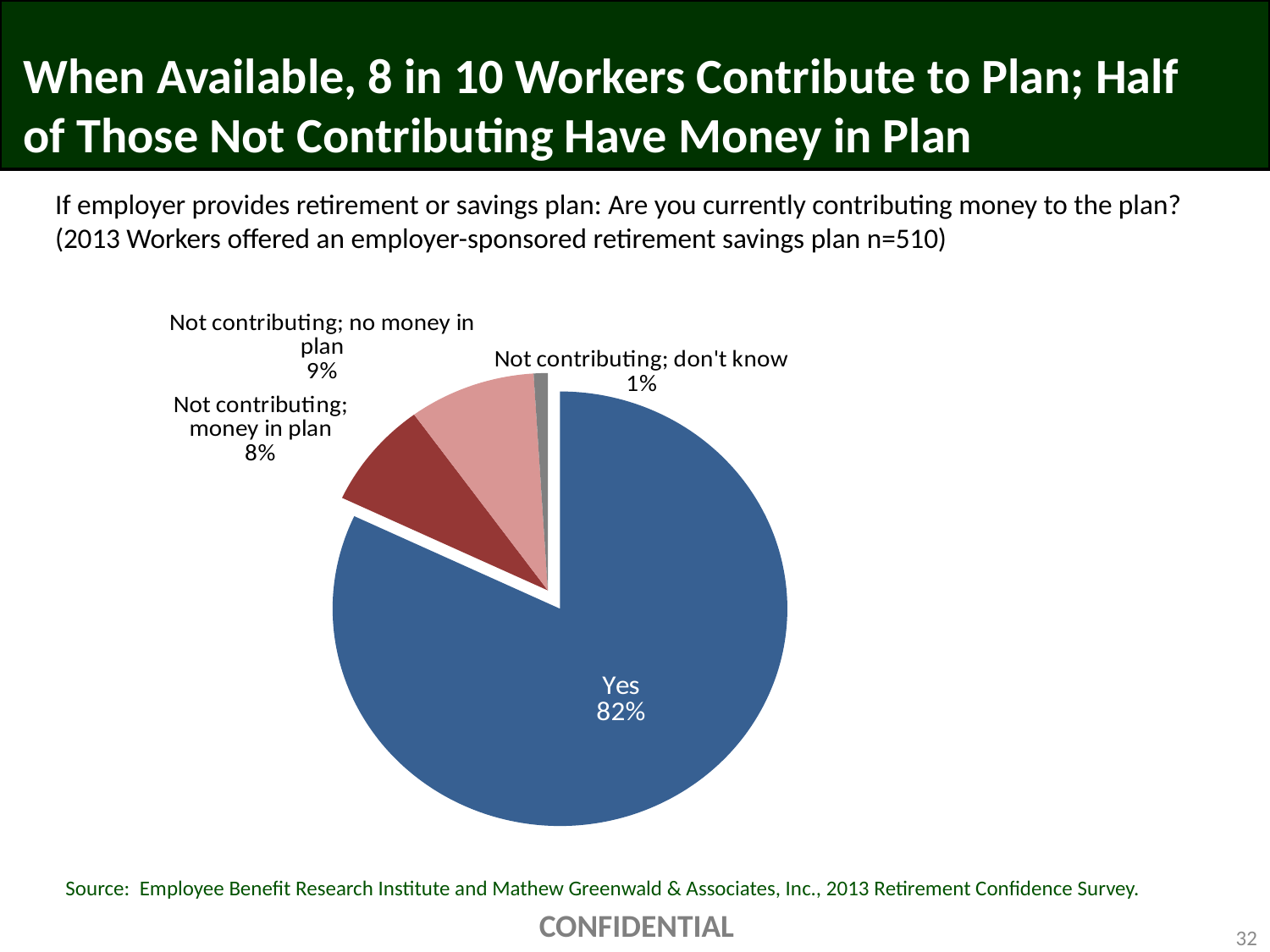
What percentage is shown for "Not contributing; no money in plan"? 9% What is the combined percentage of the three "Not contributing" slices? 18% What is the sample size (n) stated for the 2013 workers offered an employer-sponsored retirement savings plan? 510 Which slice of the pie is the smallest? Not contributing; don't know Which slice of the pie is the largest? Yes How many slices does the pie chart have? 4 What percentage of workers answered "Yes" to currently contributing money to the plan? 82% Which is larger: "Not contributing; no money in plan" or "Not contributing; money in plan"? Not contributing; no money in plan What percentage is shown for "Not contributing; don't know"? 1% What share of the pie is "Not contributing; money in plan"? 8% What kind of chart is shown on the slide? Pie chart What is the difference in percentage points between "Yes" and "Not contributing; no money in plan"? 73